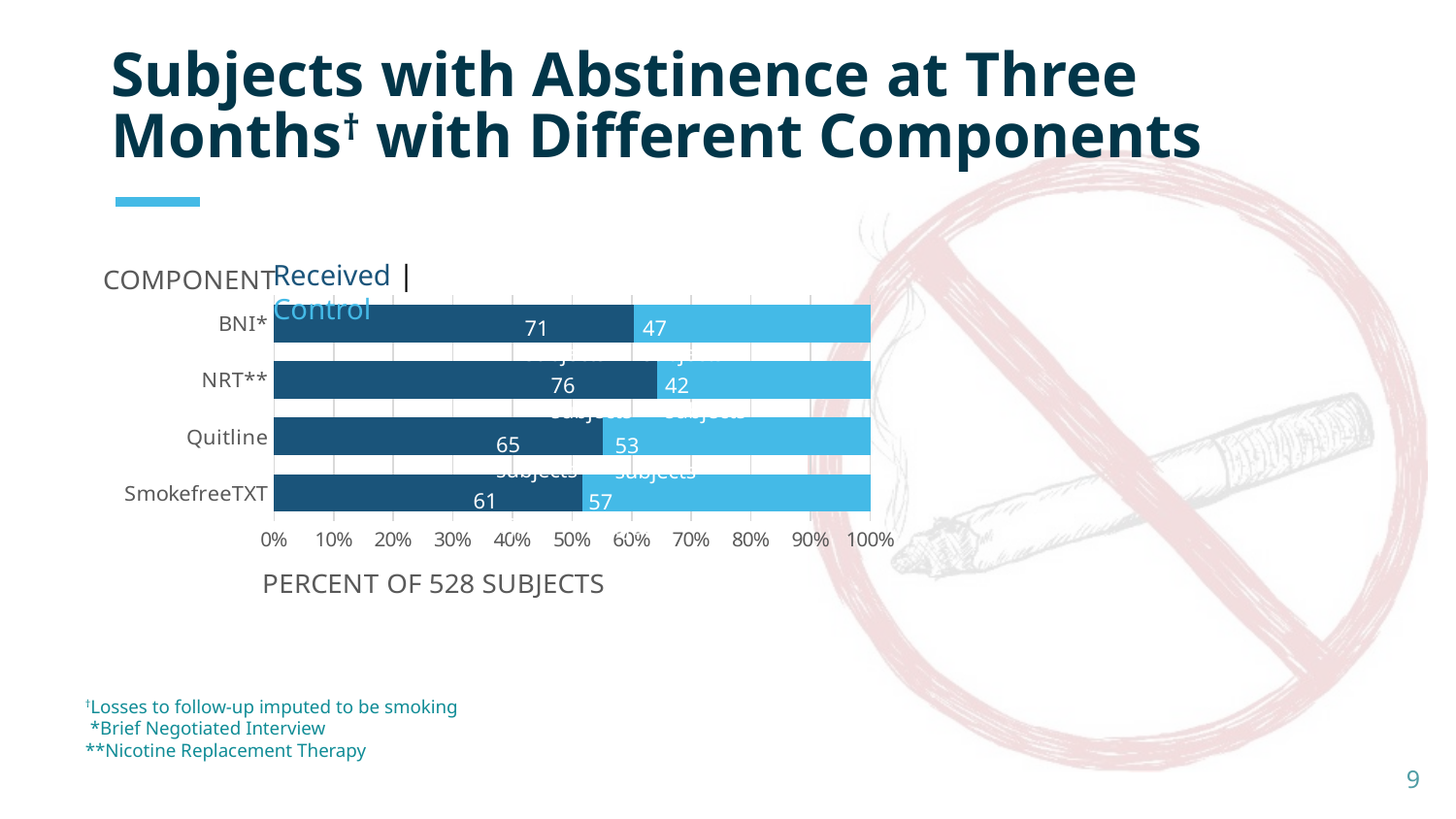
What is the Control value for Quitline? 53 What is the label of the horizontal axis? PERCENT OF 528 SUBJECTS What is the Received value for SmokefreeTXT? 61 Is the Control value larger for BNI* or for SmokefreeTXT? SmokefreeTXT What is the difference between the Received values for NRT** and Quitline? 11 How many series does the legend list? 2 What is the Received value for BNI*? 71 Which component has the lowest Received value? SmokefreeTXT How many components are shown on the chart? 4 What kind of chart is shown on the slide? Stacked bar chart What is the Control value for NRT**? 42 Which component has the highest Received value? NRT**